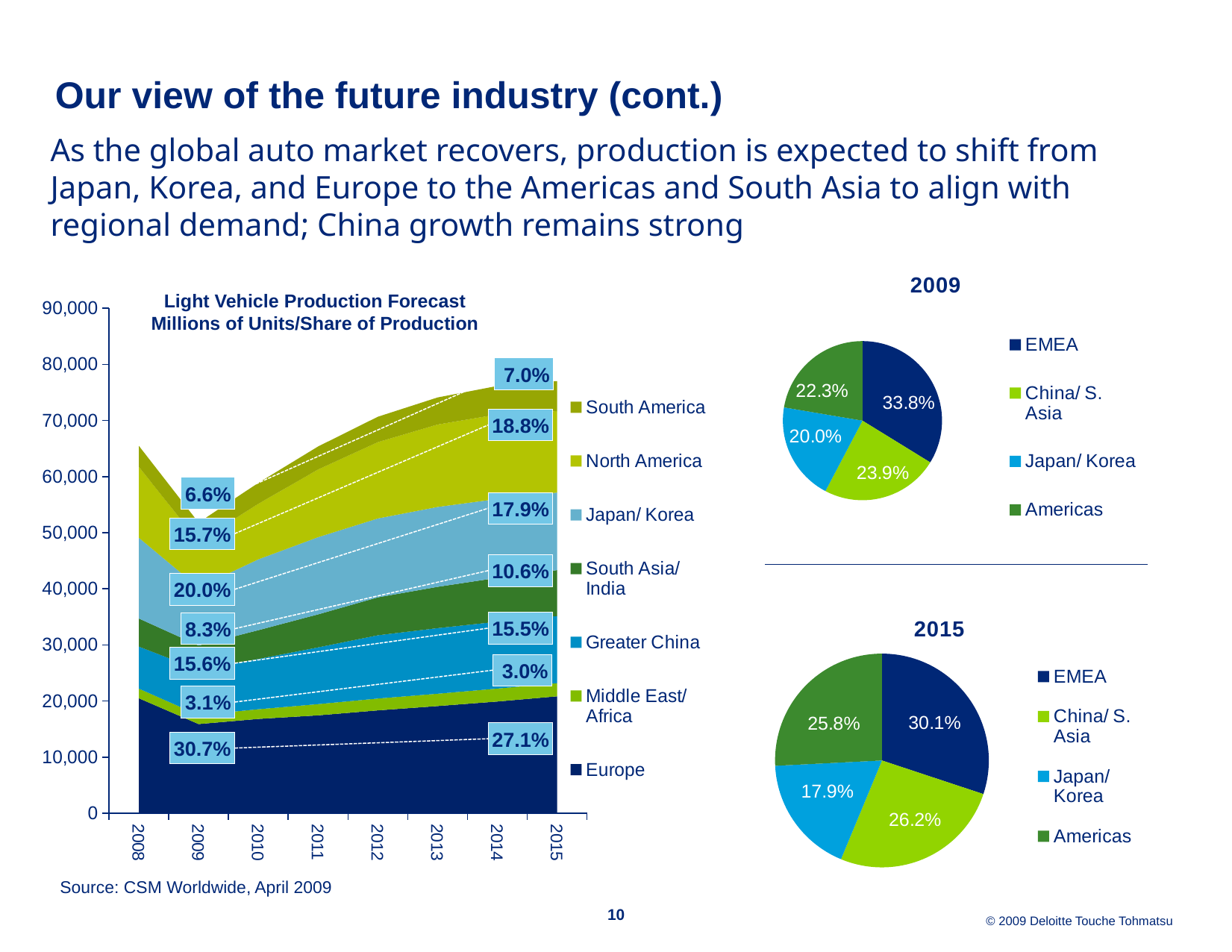
In the Light Vehicle Production Forecast chart, by how many percentage points does Europe's labelled share fall from 2009 to 2015? 3.6% In the 2009 pie chart, which region has the largest share? EMEA In the Light Vehicle Production Forecast chart, what share of production is labelled for Europe in 2009? 30.7% In the 2015 pie chart, which region has the smallest share? Japan/ Korea In the Light Vehicle Production Forecast chart, what share of production is labelled for Japan/ Korea in 2015? 17.9% In the Light Vehicle Production Forecast chart, how many years are shown on the x axis? 8 In the 2015 pie chart, which is larger, China/ S. Asia or Americas? China/ S. Asia In the 2009 pie chart, what share is shown for Japan/ Korea? 20.0% In the Light Vehicle Production Forecast chart, is the total production in 2009 greater or less than 60,000? less In the 2009 pie chart, what is the difference between the EMEA share and the Americas share? 11.5% In the Light Vehicle Production Forecast chart, how many series does the legend list? 7 What kind of chart is the Light Vehicle Production Forecast chart? Stacked area chart